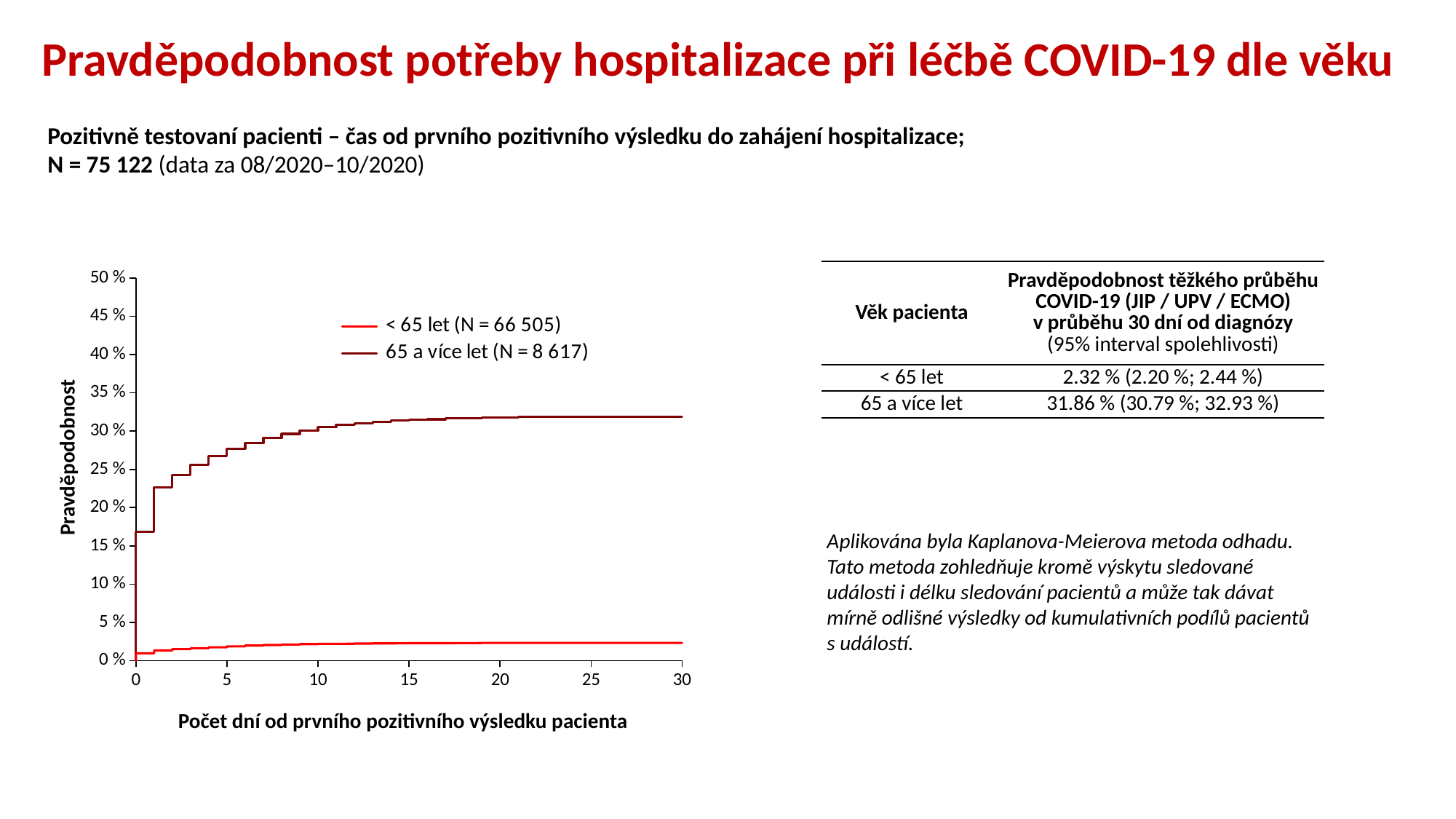
What kind of chart is shown on the slide? line chart What is the maximum number of days shown on the x axis of the chart? 30 How many series does the chart legend list? 2 What is the label of the x axis of the chart? Počet dní od prvního pozitivního výsledku pacienta Is the value for the '< 65 let' series at day 30 greater or less than 5 %? less Do the values of the '65 a více let' series rise or fall as the number of days increases? rise What is the N shown in the legend for the '< 65 let' series? 66 505 Is the value for the '65 a více let' series at day 30 greater or less than 30 %? greater Is the value for the '65 a více let' series at day 0 greater or less than 20 %? less What is the maximum value shown on the y axis of the chart? 50 % Which series in the chart has the higher probability at 30 days: '< 65 let' or '65 a více let'? 65 a více let